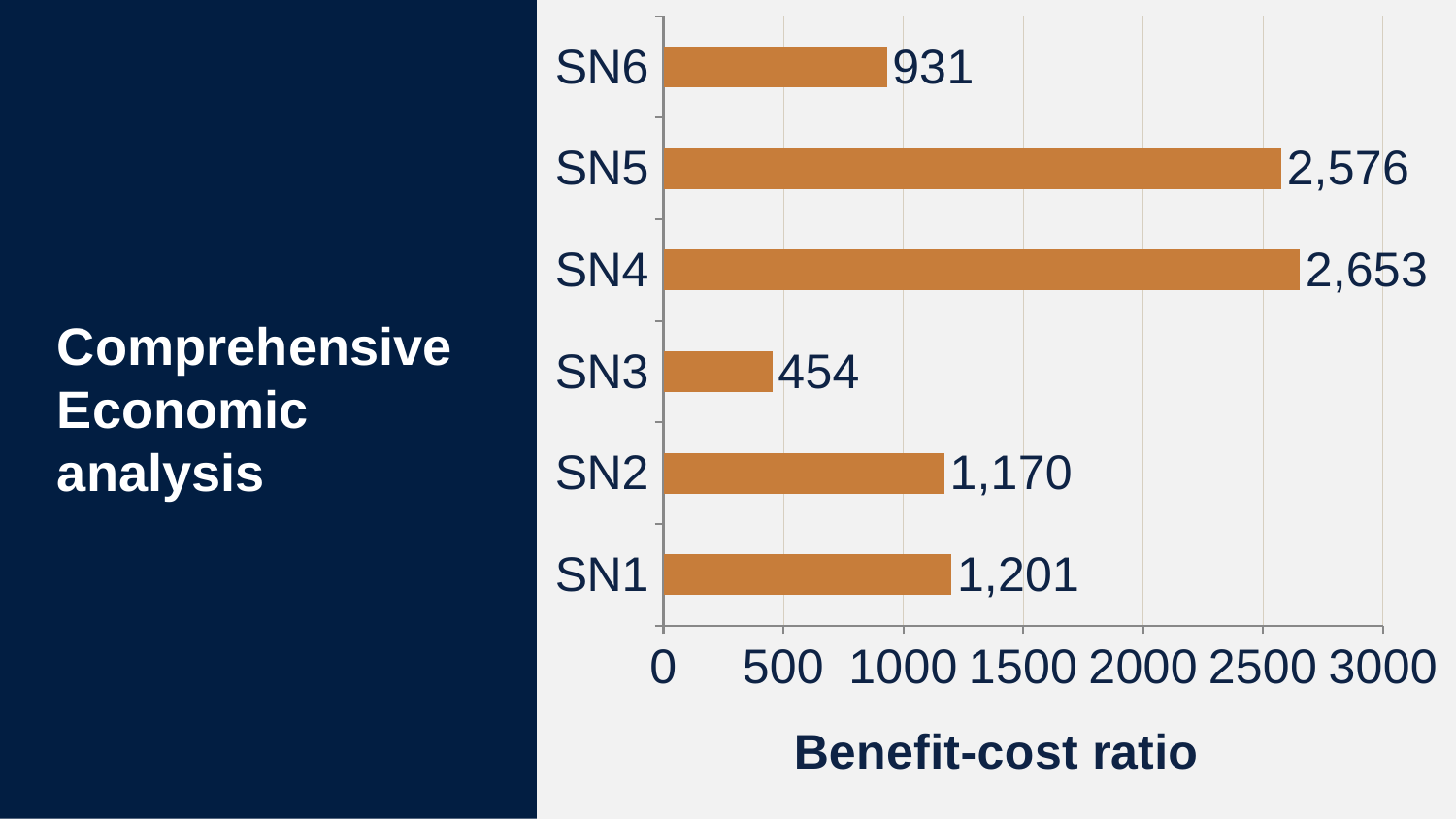
What is the benefit-cost ratio for SN3? 454 What is the difference between the benefit-cost ratios of SN4 and SN5? 77 What is the difference between the benefit-cost ratios of SN1 and SN2? 31 Which category has the highest benefit-cost ratio? SN4 Which category has the lowest benefit-cost ratio? SN3 Is the value for SN5 greater or less than 2500? greater What is the benefit-cost ratio for SN4? 2,653 Which has a larger benefit-cost ratio, SN2 or SN6? SN2 What kind of chart is shown on the slide? Bar chart What is the label of the horizontal axis? Benefit-cost ratio What is the benefit-cost ratio for SN6? 931 How many categories are shown in the chart? 6